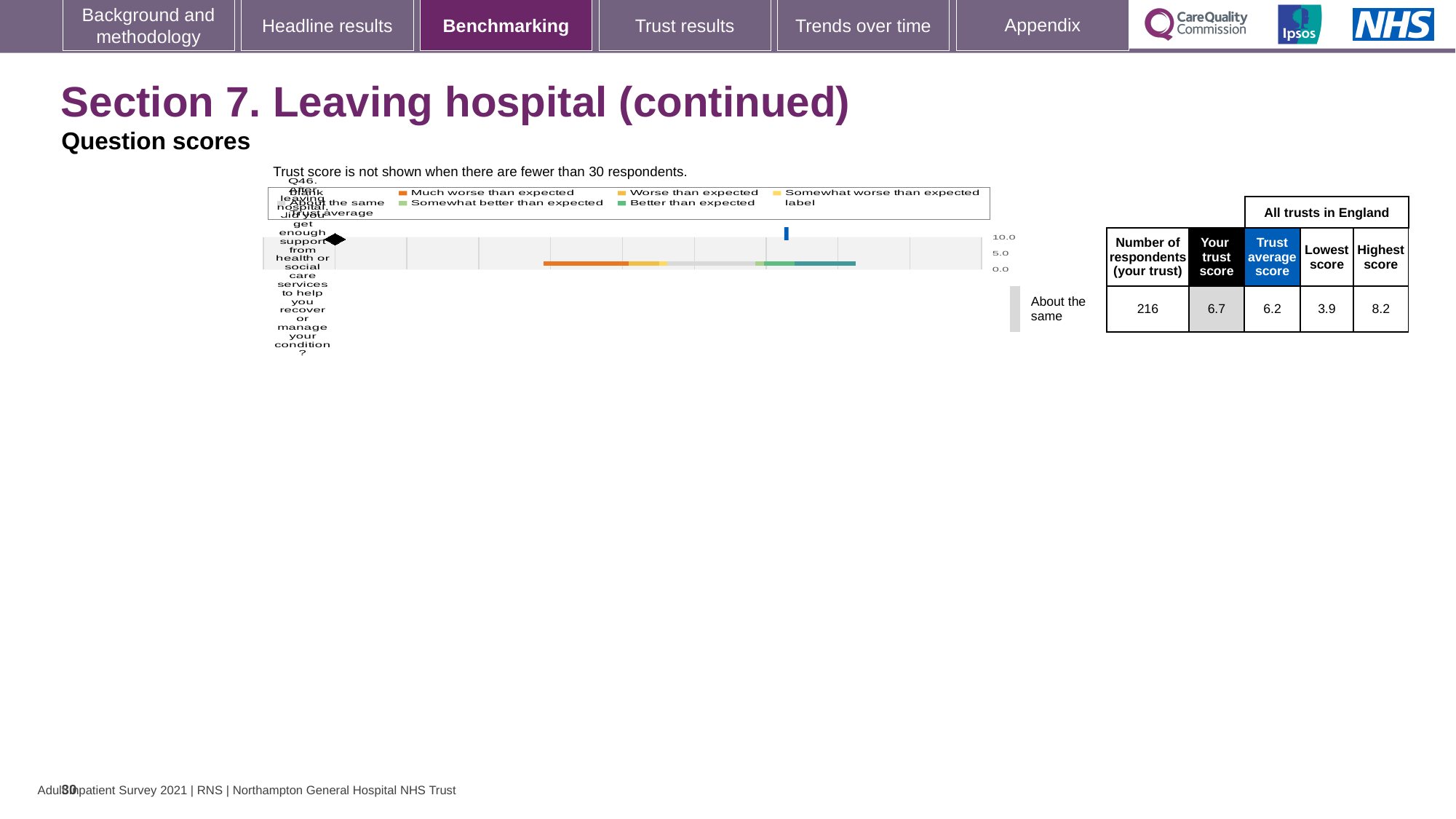
What is the difference between the trust's score and the trust average score for Q46? 0.5 How many questions (categories) are plotted on the chart? 1 Which question number is plotted on the chart? Q46 What kind of chart is shown on the slide? bar chart According to the table beside the chart, what is the trust's score for Q46? 6.7 How many respondents from the trust answered Q46? 216 What is the highest value shown on the chart's score axis? 10.0 Which is larger for Q46: the trust's score or the trust average score? the trust's score According to the table beside the chart, what is the highest score among all trusts in England for Q46? 8.2 According to the table beside the chart, what is the lowest score among all trusts in England for Q46? 3.9 According to the table beside the chart, what is the trust average score for Q46? 6.2 Is the trust's score for Q46 greater or less than 5.0 on the chart's axis? greater